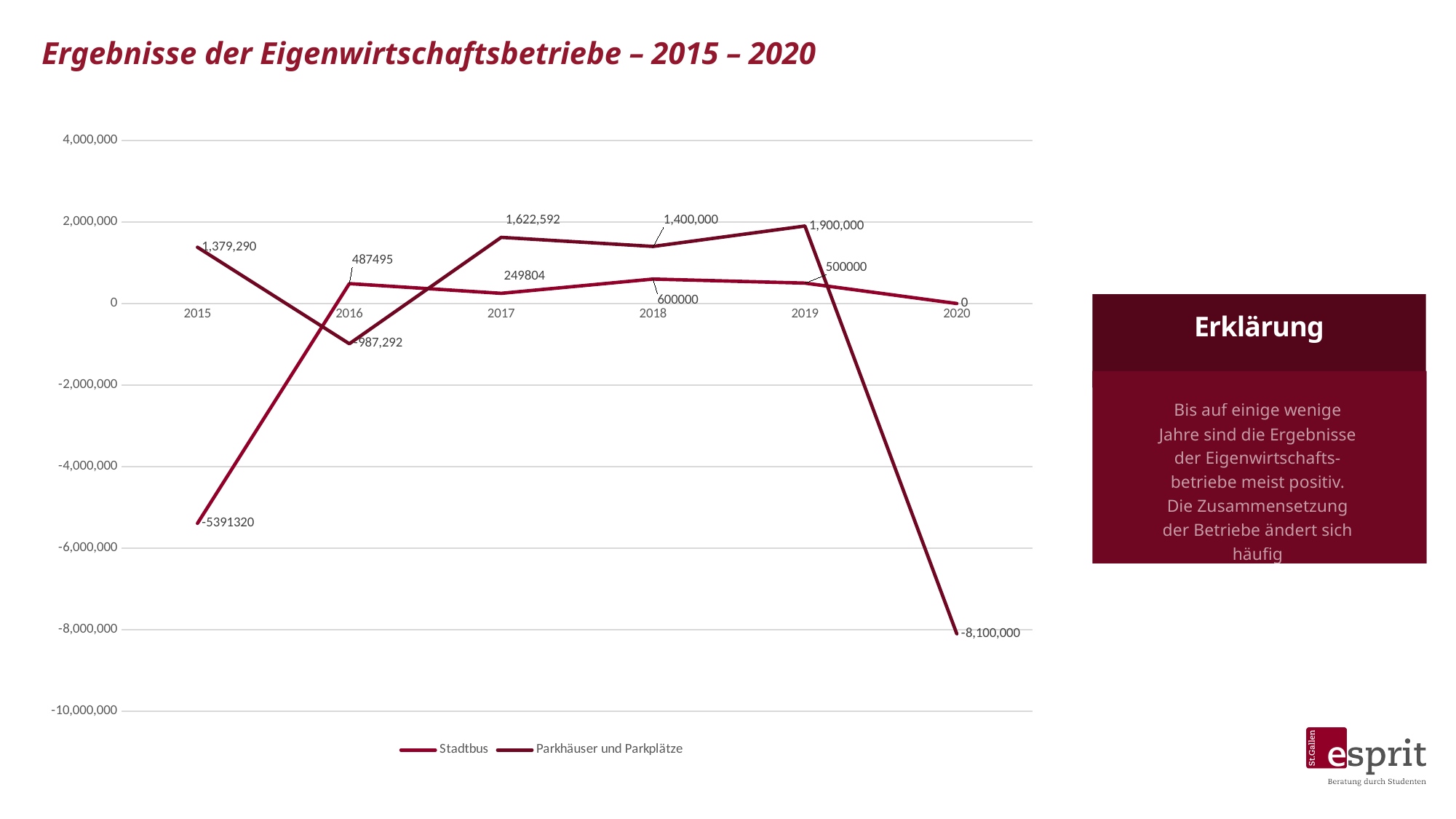
What is the value for Stadtbus in 2015? -5391320 How many series does the legend list? 2 Which series has the larger value in 2016, Stadtbus or Parkhäuser und Parkplätze? Stadtbus What is the value for Parkhäuser und Parkplätze in 2017? 1,622,592 What is the difference between the Parkhäuser und Parkplätze value in 2019 and the Stadtbus value in 2019? 1,400,000 What kind of chart is shown on the slide? line chart What is the title of the chart? Ergebnisse der Eigenwirtschaftsbetriebe – 2015 – 2020 How many years are plotted along the x axis? 6 What is the value for Stadtbus in 2018? 600000 In which year is the value for Stadtbus lowest? 2015 What is the value for Parkhäuser und Parkplätze in 2020? -8,100,000 In which year is the value for Parkhäuser und Parkplätze highest? 2019